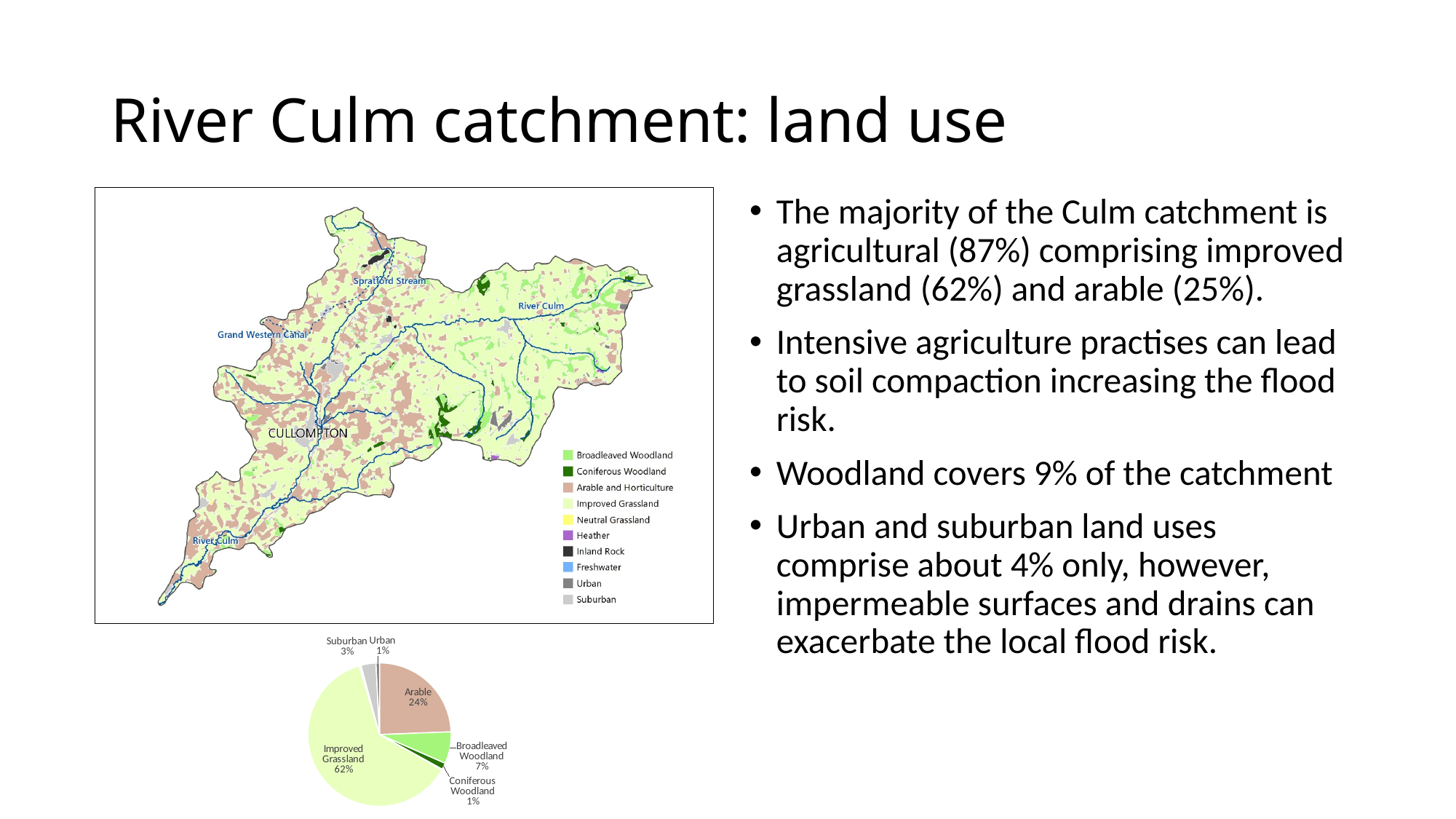
In the pie chart, what percentage is shown for Suburban? 3% In the pie chart, what percentage is shown for Broadleaved Woodland? 7% In the pie chart, what is the combined share of Broadleaved Woodland and Coniferous Woodland? 8% In the pie chart, what is the difference in percentage points between Improved Grassland and Arable? 38 Which category has the largest slice in the pie chart? Improved Grassland In the pie chart, which category is shown with the dark green slice? Coniferous Woodland In the pie chart, what percentage is shown for Arable? 24% In the pie chart, what is the difference in percentage points between Arable and Broadleaved Woodland? 17 In the pie chart, which is larger: Arable or Broadleaved Woodland? Arable In the pie chart, what percentage is shown for Improved Grassland? 62% What type of chart is shown at the bottom left of the slide? pie chart